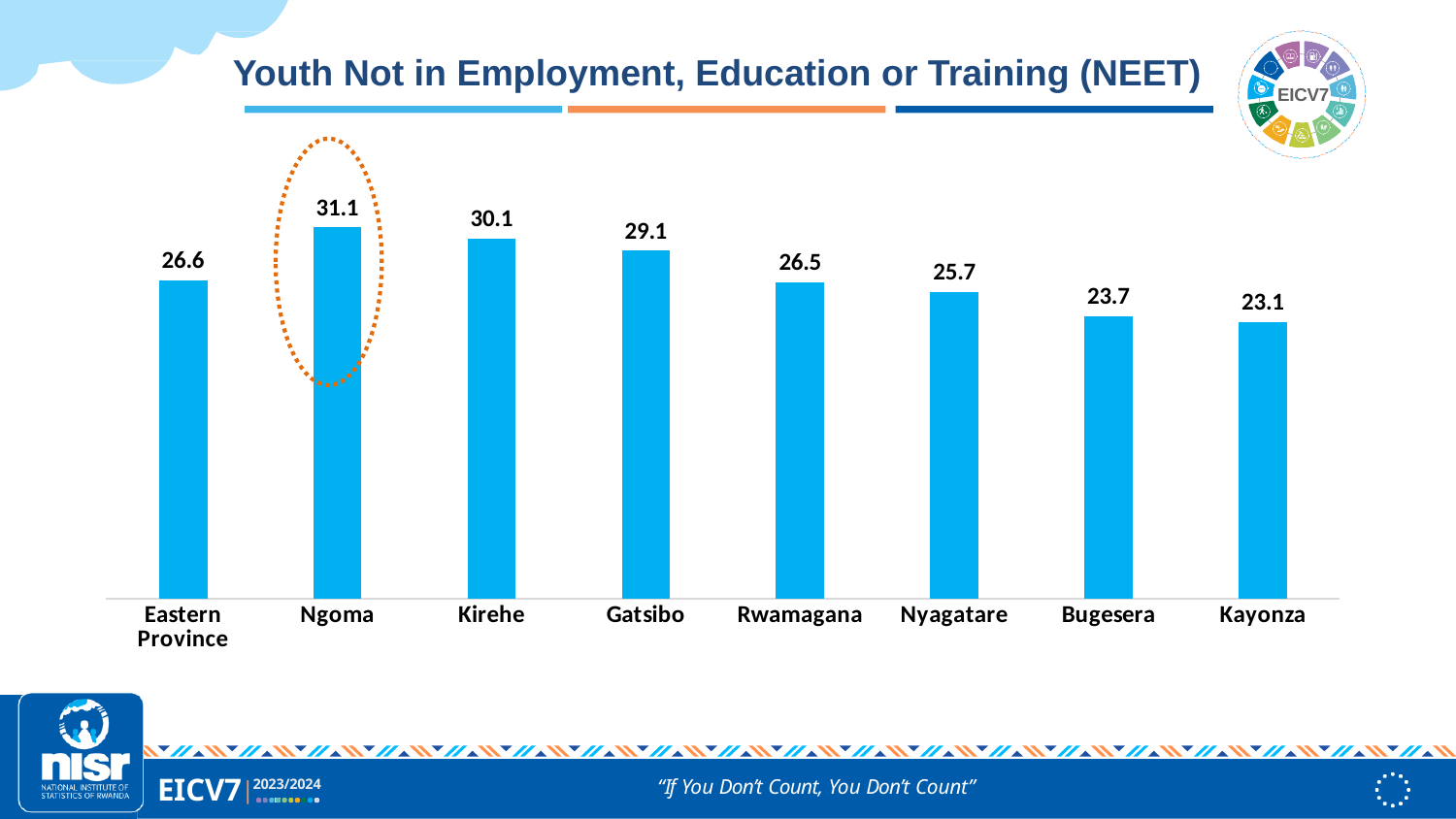
What is the NEET value for Bugesera? 23.7 What is the difference between the NEET values for Kirehe and Gatsibo? 1.0 How many categories are shown on the chart? 8 What is the difference between the NEET values for Ngoma and Kayonza? 8.0 What kind of chart is shown on the slide? Bar chart What is the title of the chart? Youth Not in Employment, Education or Training (NEET) What is the NEET value for Ngoma? 31.1 Which category has the lowest NEET value? Kayonza Which district has the highest NEET value? Ngoma Which has a higher NEET value, Rwamagana or Nyagatare? Rwamagana What is the NEET value for Eastern Province? 26.6 Which bar is highlighted with a dotted orange circle? Ngoma